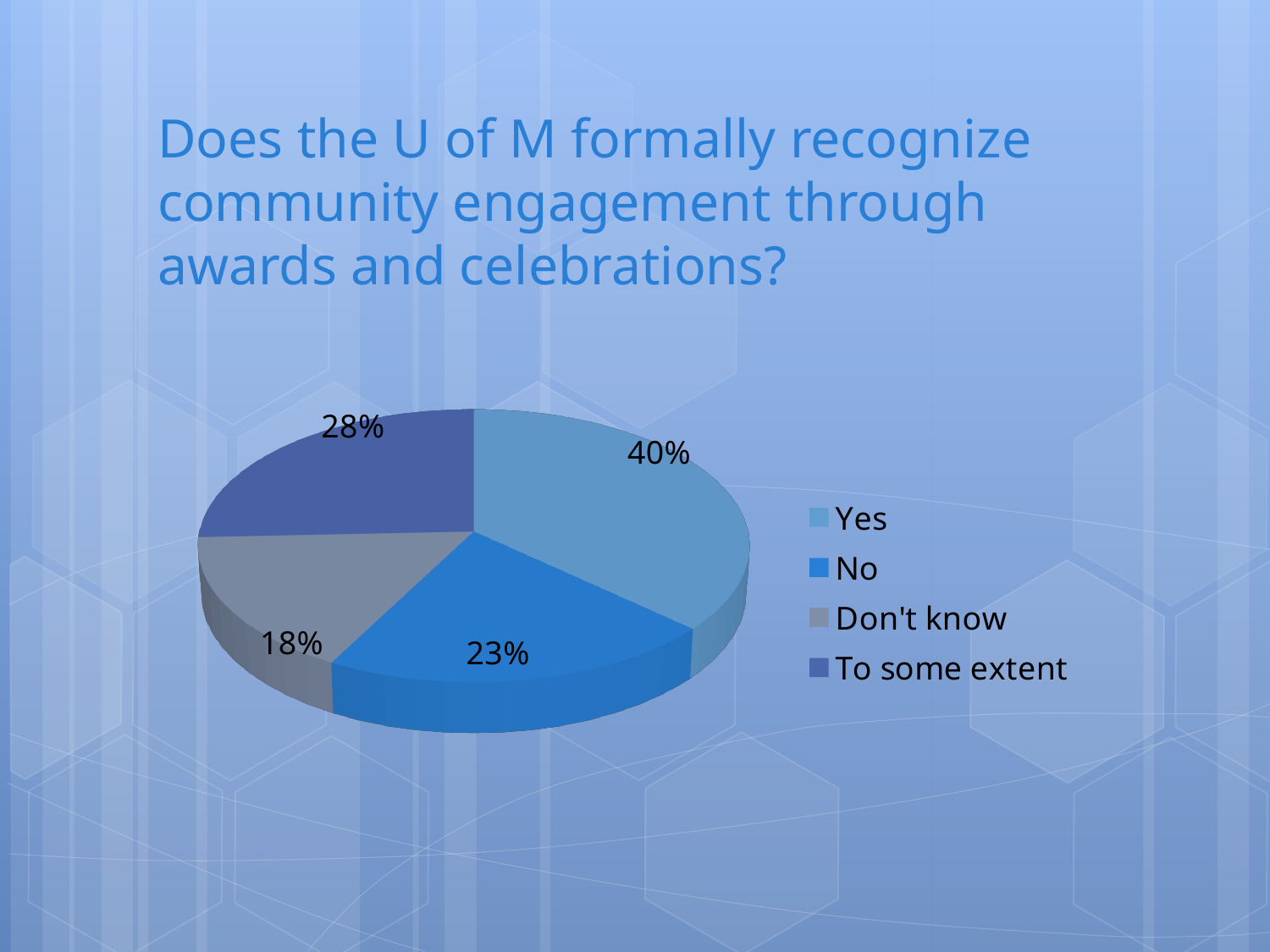
What kind of chart is shown on the slide? Pie chart What percentage of respondents answered "Don't know"? 18% Which is larger, the share for "To some extent" or the share for "No"? To some extent Which legend entry is shown in the darkest blue colour? To some extent Which response has the smallest share of the pie? Don't know What is the combined share of "Yes" and "To some extent"? 68% Which response has the largest share of the pie? Yes What percentage of respondents answered "To some extent"? 28% What is the difference in percentage points between "Yes" and "No"? 17 What percentage of respondents answered "Yes"? 40% What percentage of respondents answered "No"? 23% How many slices does the pie chart have? 4